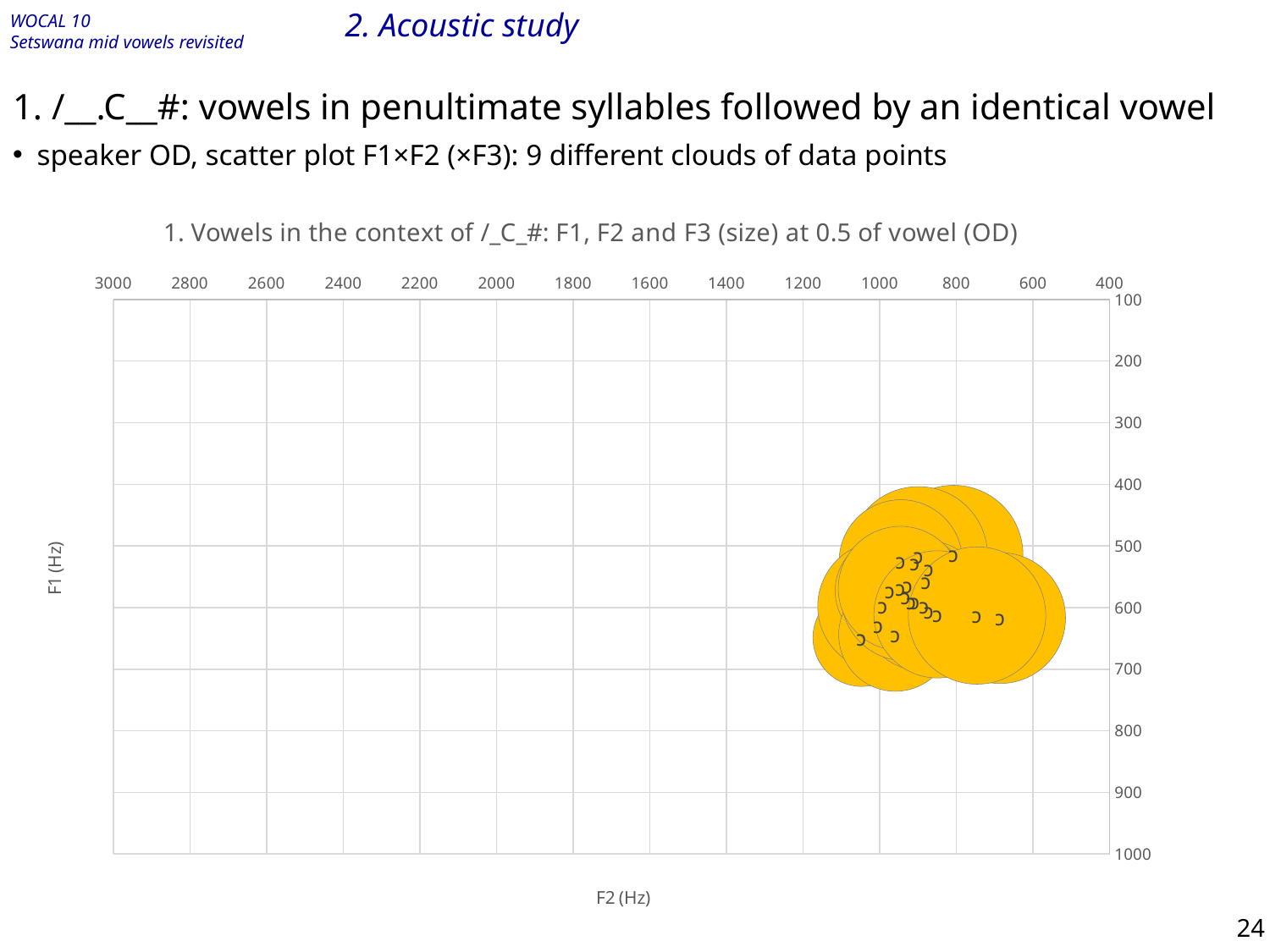
What kind of chart is shown on the slide? scatter plot (bubble chart) Are the F2 (Hz) values of the plotted points greater or less than 1400? less Are the F2 (Hz) values of the plotted points greater or less than 400? greater Are the F1 (Hz) values of the plotted points greater or less than 400? greater What does the size of the bubbles in the chart represent? F3 What is the title of the chart? 1. Vowels in the context of /_C_#: F1, F2 and F3 (size) at 0.5 of vowel (OD)